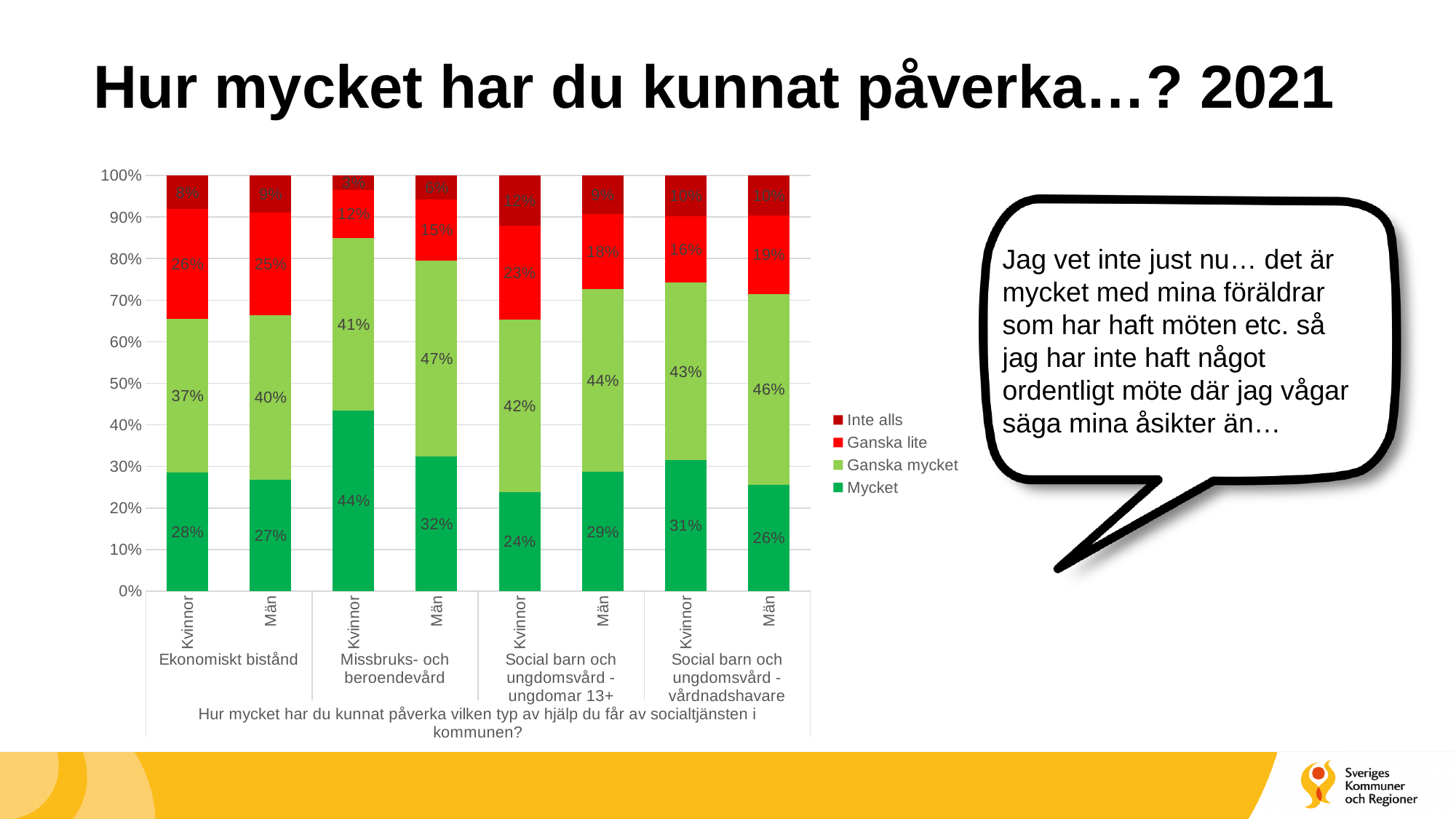
Which is larger: the 'Ganska lite' value for Kvinnor in Ekonomiskt bistånd or for Kvinnor in Social barn och ungdomsvård - vårdnadshavare? Kvinnor in Ekonomiskt bistånd What is the 'Ganska mycket' value for Män in Social barn och ungdomsvård - vårdnadshavare? 46% Which bar has the lowest 'Mycket' value? Kvinnor, Social barn och ungdomsvård - ungdomar 13+ How many series does the legend list? 4 What kind of chart is shown on the slide? Stacked bar chart Which bar has the highest 'Mycket' value? Kvinnor, Missbruks- och beroendevård What is the 'Inte alls' value for Kvinnor in Social barn och ungdomsvård - ungdomar 13+? 12% What is the 'Mycket' value for Kvinnor in Missbruks- och beroendevård? 44% How many bars are plotted in the chart? 8 Which legend entry is shown in dark red? Inte alls What is the 'Ganska lite' value for Män in Ekonomiskt bistånd? 25% What is the difference between the 'Ganska mycket' values for Män and Kvinnor in Missbruks- och beroendevård? 6%